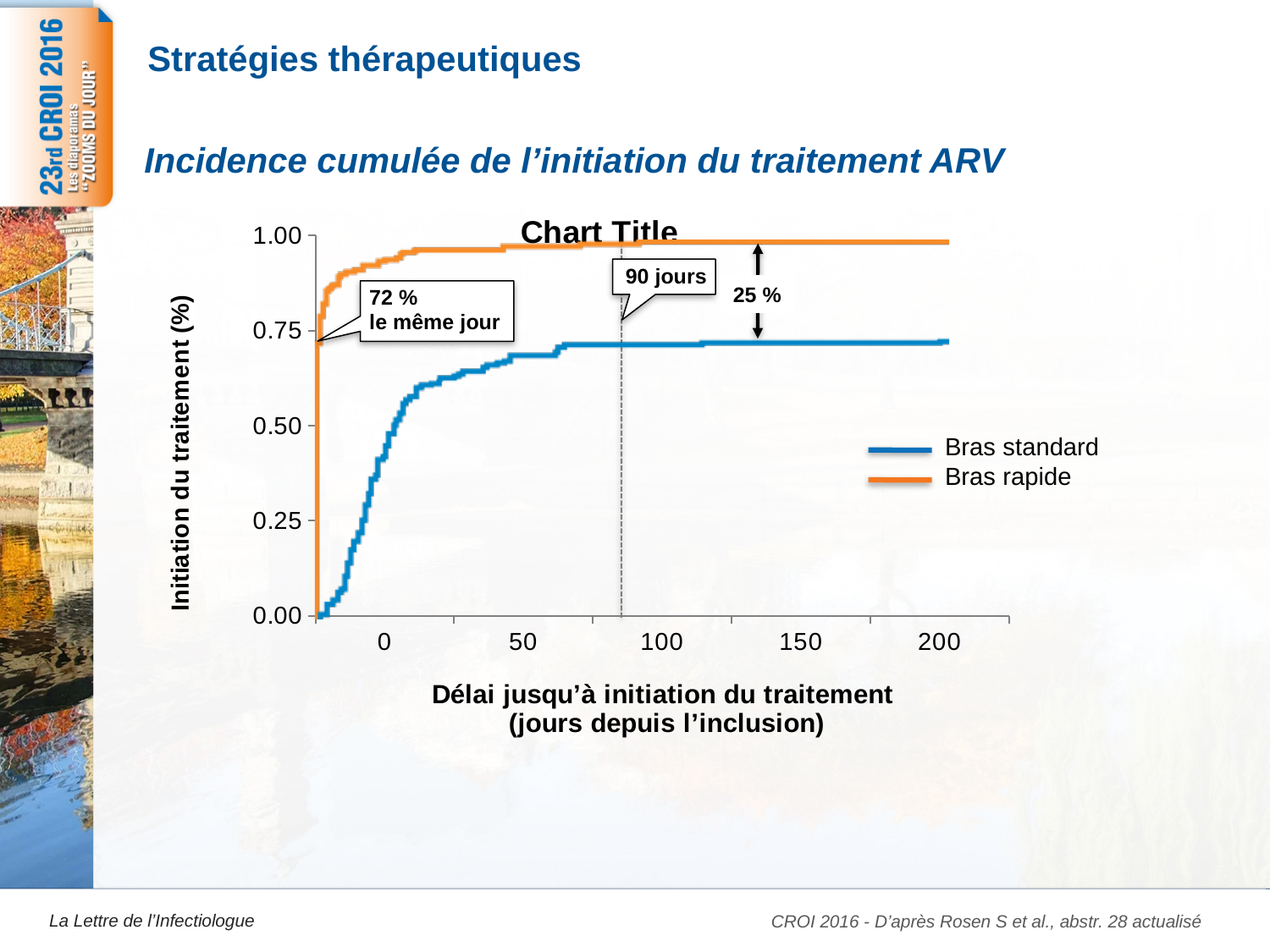
What are the two series named in the legend? Bras standard, Bras rapide How many series does the legend list? 2 What kind of chart is shown on the slide? Line chart Is the value for Bras rapide at 100 days greater or less than 0.75? greater Is the value for Bras standard at 200 days greater or less than 0.75? less Is the value for Bras standard at 200 days greater or less than 0.50? greater Which series is higher at 50 days, Bras standard or Bras rapide? Bras rapide At what time point does the dashed vertical line mark the comparison between the arms? 90 jours According to the annotation, what percentage of the Bras rapide arm initiated treatment the same day? 72 % Which colour represents the Bras rapide series? Orange Do the values of the Bras standard series rise or fall along the x axis? Rise According to the annotation, what is the difference between the two arms at 90 days? 25 %